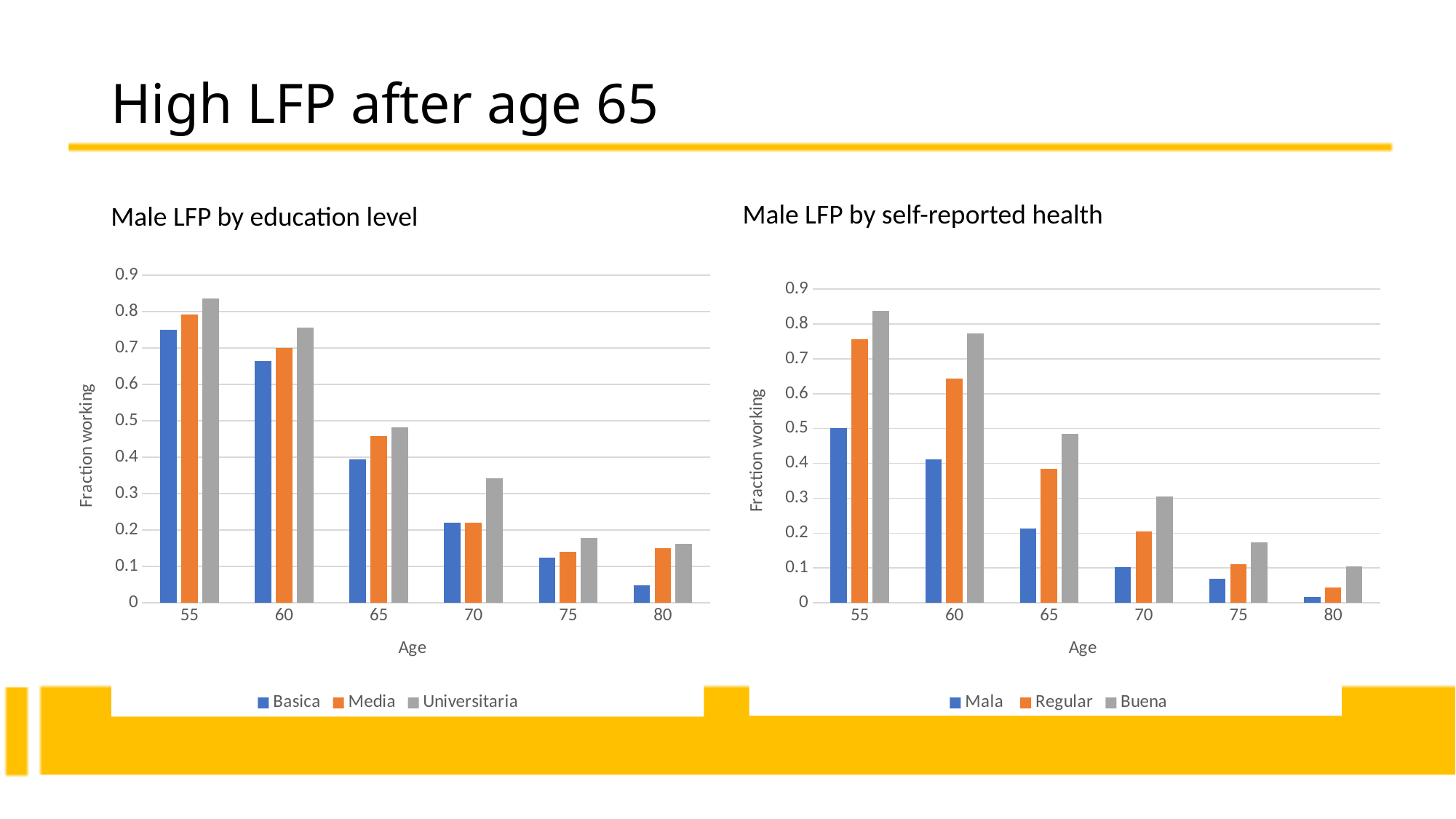
What type of chart is the 'Male LFP by education level' chart? bar chart In the 'Male LFP by self-reported health' chart, does the fraction working for Buena rise or fall as age increases from 55 to 80? fall In the 'Male LFP by education level' chart, at which age is the Basica fraction working lowest? 80 In the 'Male LFP by self-reported health' chart, is the value for Regular at age 65 greater or less than 0.3? greater In the 'Male LFP by education level' chart, is the value for Universitaria at age 70 greater or less than 0.4? less How many age categories are shown on the x axis of the 'Male LFP by education level' chart? 6 How many series does the legend of the 'Male LFP by self-reported health' chart list? 3 What is the y-axis label of the 'Male LFP by self-reported health' chart? Fraction working In the 'Male LFP by education level' chart, which education level has the highest fraction working at age 65? Universitaria In the 'Male LFP by education level' chart, is the value for Basica at age 55 greater or less than 0.7? greater In the 'Male LFP by self-reported health' chart, which health category has the highest fraction working at age 60? Buena In the 'Male LFP by self-reported health' chart, which is larger at age 75: Mala or Buena? Buena